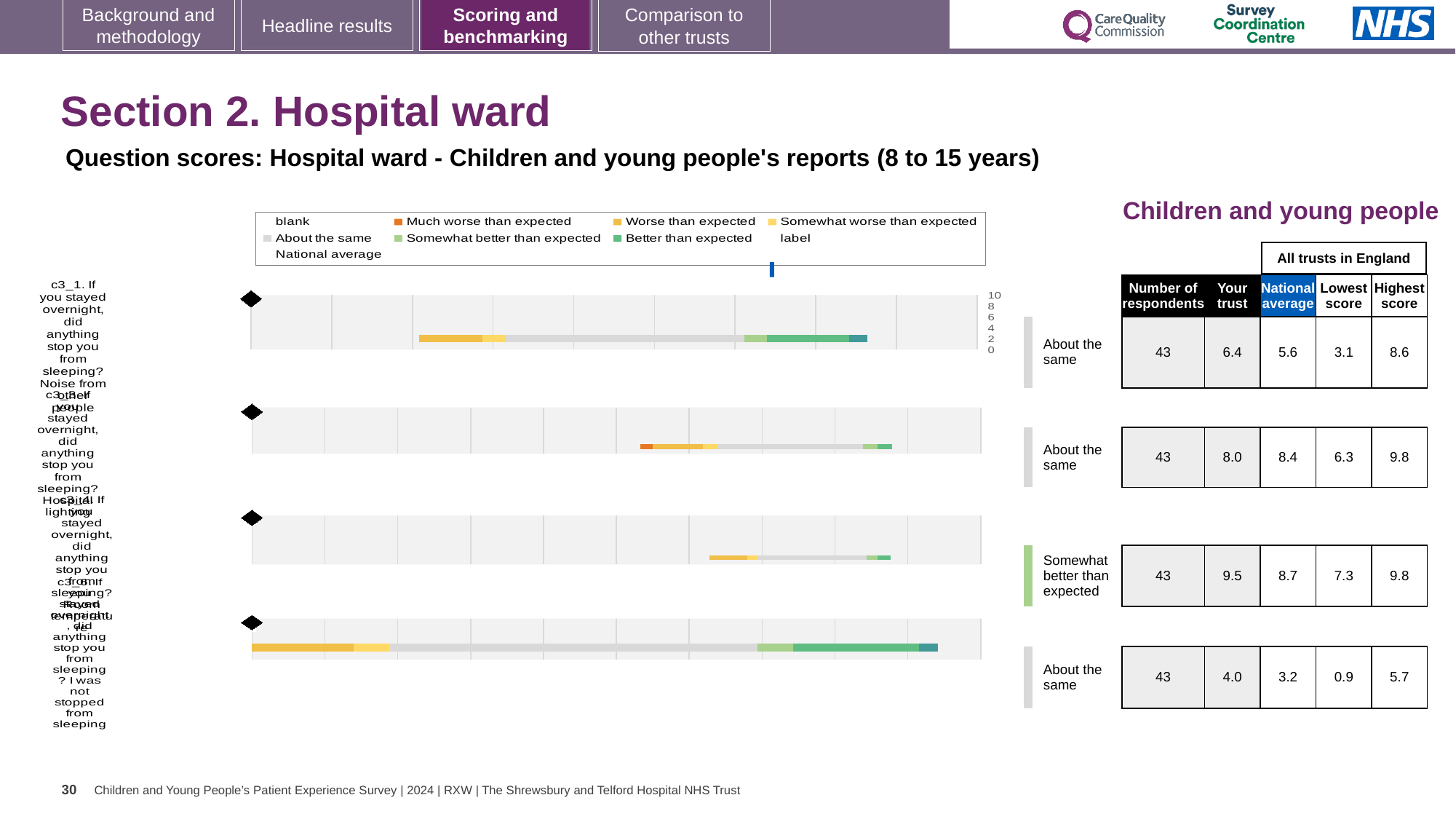
For the second row, which is larger: the 'Your trust' score or the National average? National average (8.4) For the fourth (bottom) row, what is the difference between the Highest score and the Lowest score? 4.8 Which row in the table has the lowest 'Your trust' score? the fourth row (4.0) How many respondents are listed for each question in the table? 43 Which row in the table has the highest 'Your trust' score? the third row (9.5) For the third row, how much higher is the 'Your trust' score than the National average? 0.8 In the table, what is the 'Your trust' score for the third row (rated 'Somewhat better than expected')? 9.5 What kind of chart is used to show the question scores on this slide? bar chart What is the Highest score listed for the fourth (bottom) row? 5.7 How many entries does the legend above the charts list? 9 How many question bars are plotted on the slide? 4 In the table, what is the National average for the first (top) row? 5.6